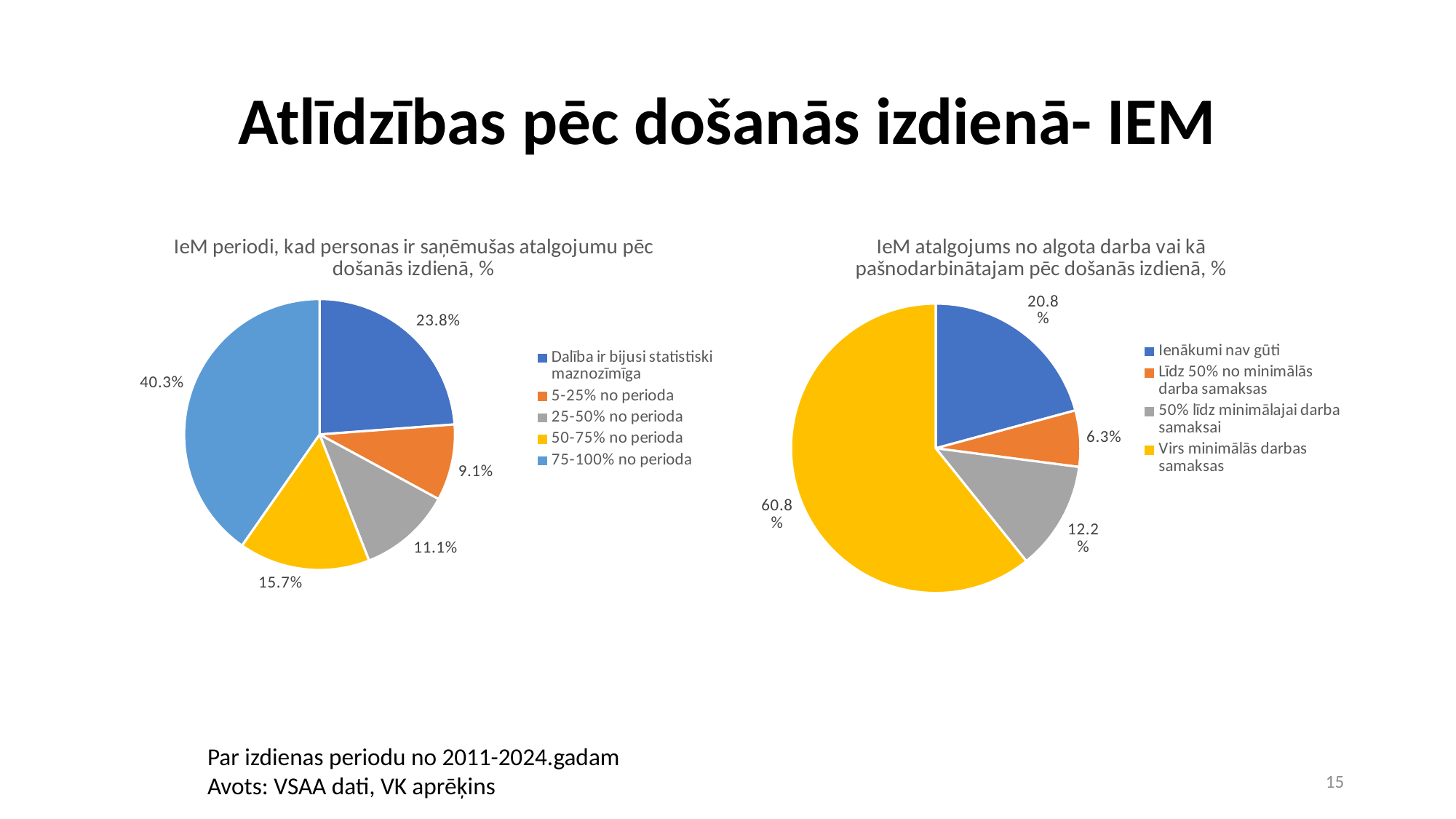
In the right chart (IeM atalgojums no algota darba vai kā pašnodarbinātajam pēc došanās izdienā, %), which is larger: the '50% līdz minimālajai darba samaksai' slice or the 'Līdz 50% no minimālās darba samaksas' slice? 50% līdz minimālajai darba samaksai In the right chart (IeM atalgojums no algota darba vai kā pašnodarbinātajam pēc došanās izdienā, %), what share is labelled for 'Virs minimālās darbas samaksas'? 60.8% In the left chart (IeM periodi, kad personas ir saņēmušas atalgojumu pēc došanās izdienā, %), what share is labelled for '75-100% no perioda'? 40.3% In the left chart (IeM periodi, kad personas ir saņēmušas atalgojumu pēc došanās izdienā, %), which category has the largest slice? 75-100% no perioda What type of chart is used for both charts on the slide? Pie chart In the left chart (IeM periodi, kad personas ir saņēmušas atalgojumu pēc došanās izdienā, %), how many categories does the legend list? 5 In the right chart (IeM atalgojums no algota darba vai kā pašnodarbinātajam pēc došanās izdienā, %), what share is labelled for 'Ienākumi nav gūti'? 20.8% In the right chart (IeM atalgojums no algota darba vai kā pašnodarbinātajam pēc došanās izdienā, %), which category has the smallest slice? Līdz 50% no minimālās darba samaksas In the left chart (IeM periodi, kad personas ir saņēmušas atalgojumu pēc došanās izdienā, %), what share is labelled for '5-25% no perioda'? 9.1% In the right chart (IeM atalgojums no algota darba vai kā pašnodarbinātajam pēc došanās izdienā, %), what is the difference between the 'Virs minimālās darbas samaksas' slice and the 'Ienākumi nav gūti' slice? 40.0% In the left chart (IeM periodi, kad personas ir saņēmušas atalgojumu pēc došanās izdienā, %), what is the difference between the '75-100% no perioda' slice and the 'Dalība ir bijusi statistiski maznozīmīga' slice? 16.5% In the left chart (IeM periodi, kad personas ir saņēmušas atalgojumu pēc došanās izdienā, %), which category has the smallest slice? 5-25% no perioda